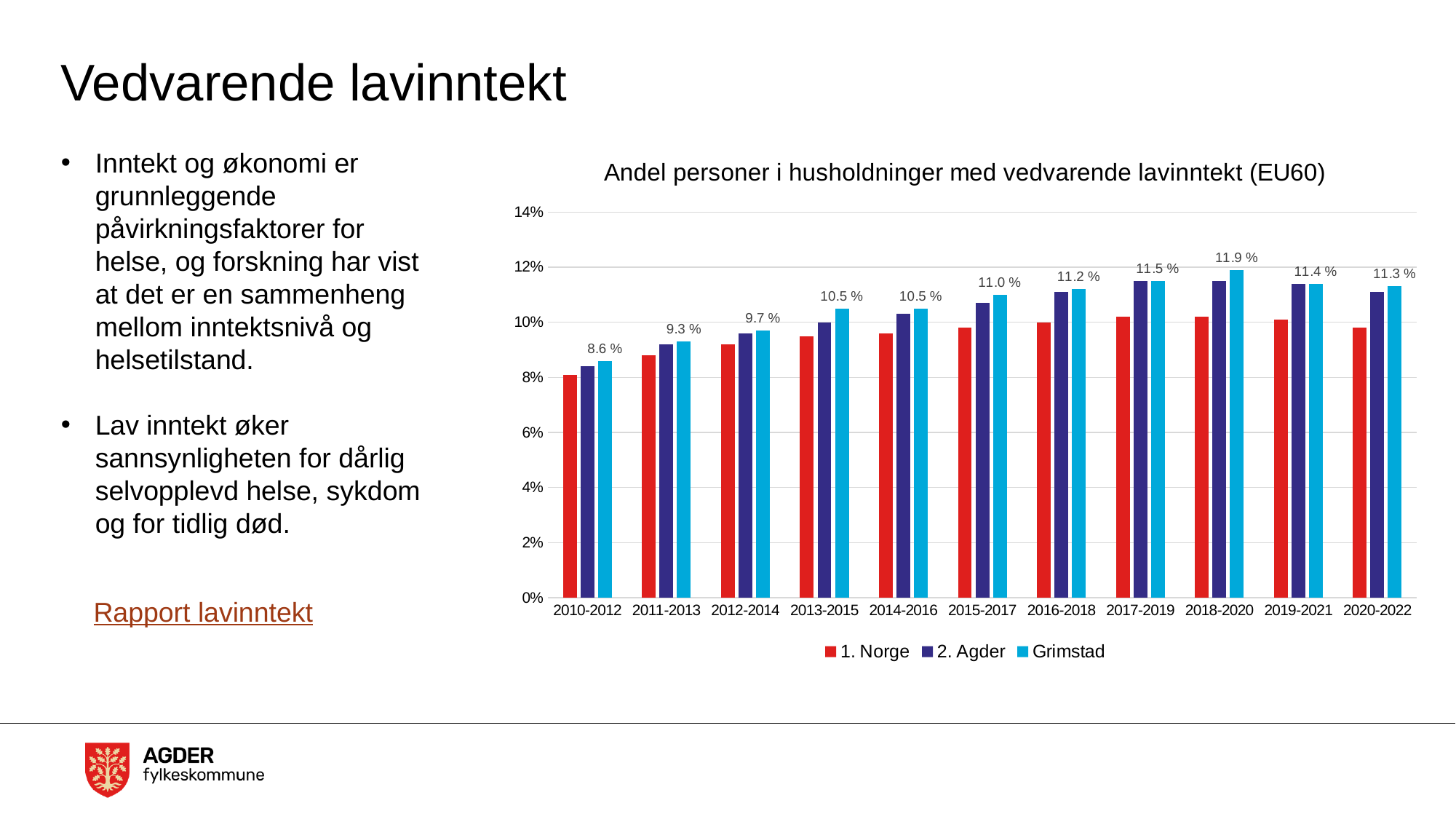
What kind of chart is shown on the slide? Bar chart What is the difference between the Grimstad value in 2018-2020 and in 2010-2012? 3.3 percentage points How many periods are shown on the x axis? 11 In which period is the Grimstad value lowest? 2010-2012 How many series does the legend list? 3 Which is larger for Grimstad: the value in 2012-2014 or in 2011-2013? 2012-2014 In which period is the Grimstad value highest? 2018-2020 Is the value for 1. Norge in 2010-2012 greater or less than 10%? less What is the value for Grimstad in 2018-2020? 11.9 % What is the value for Grimstad in 2010-2012? 8.6 % What is the value for Grimstad in 2015-2017? 11.0 % Which series is shown in red in the legend? 1. Norge